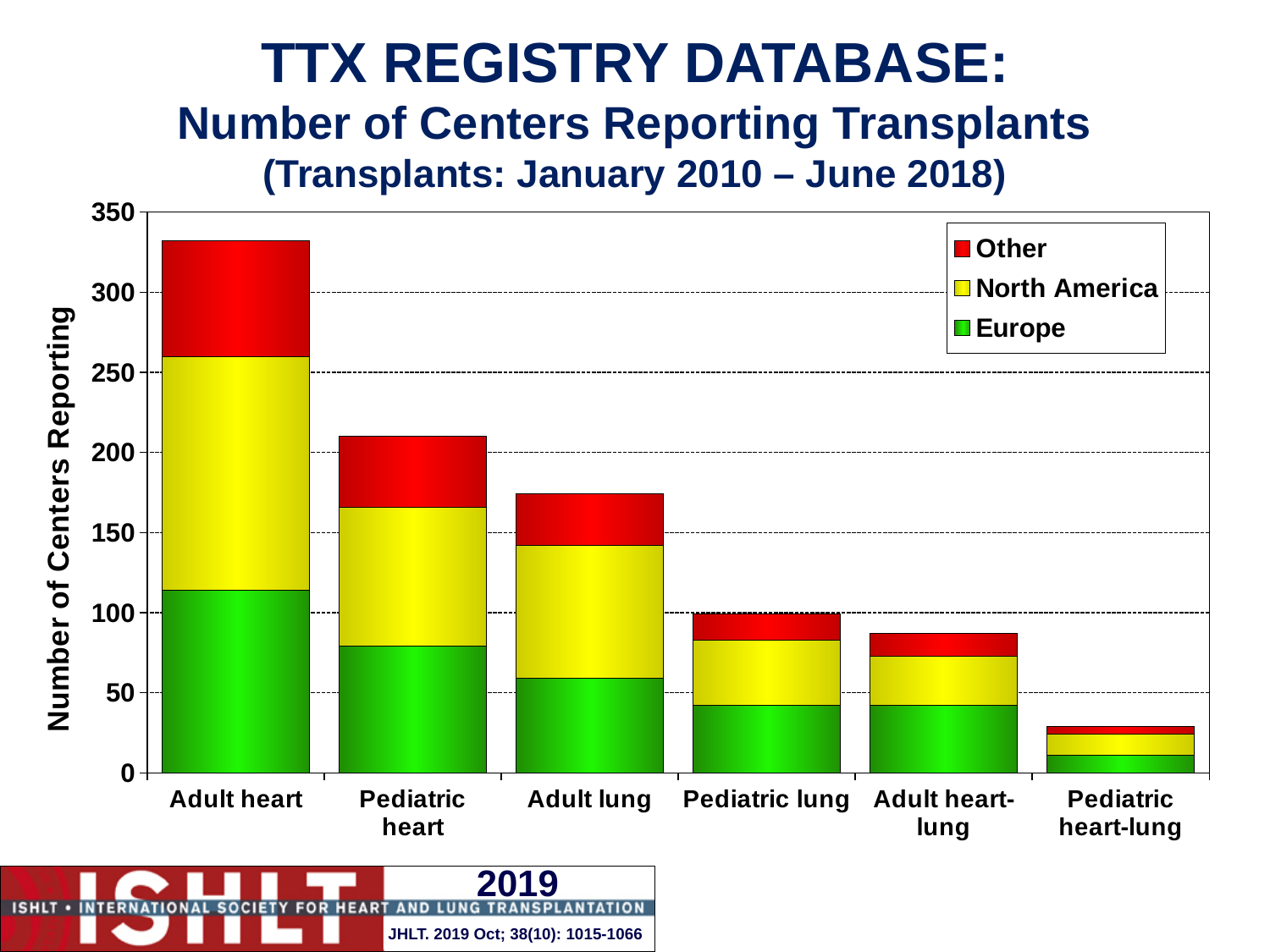
Which category has the lowest total number of centers reporting? Pediatric heart-lung Is the total number of centers reporting for Adult heart greater or less than 300? greater Which category has the highest total number of centers reporting? Adult heart Is the total number of centers reporting for Pediatric heart-lung greater or less than 50? less Is the total number of centers reporting for Adult heart-lung greater or less than 100? less Which colour represents North America in the chart? Yellow Which has a larger total number of centers reporting, Pediatric heart or Adult lung? Pediatric heart How many series does the legend list? 3 What kind of chart is shown on the slide? Stacked bar chart How many transplant categories are shown on the x axis? 6